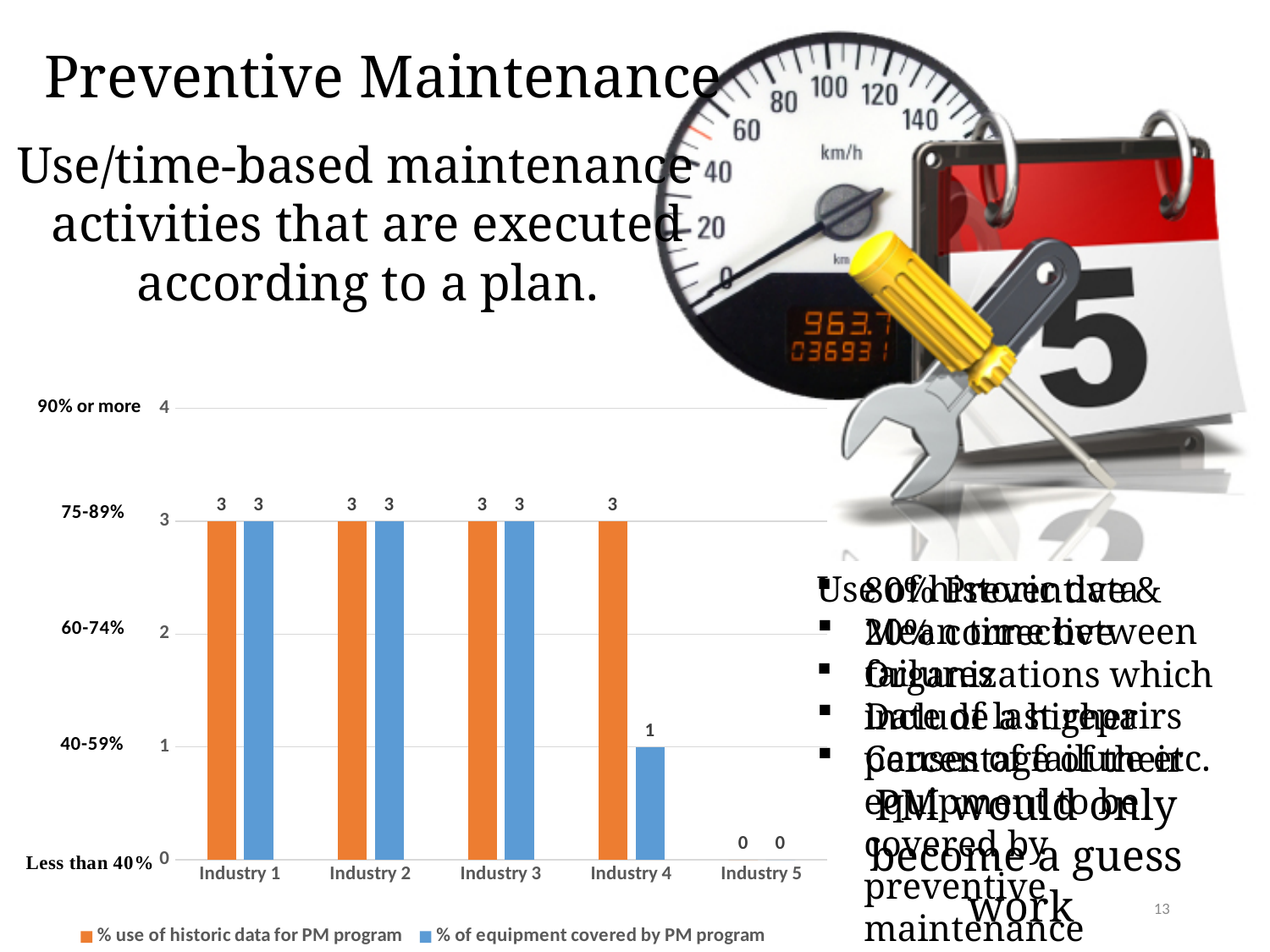
How many series does the chart legend list? 2 What is the value for Industry 5 in the '% use of historic data for PM program' series? 0 What is the value for Industry 2 in the '% of equipment covered by PM program' series? 3 What is the y-axis label shown next to the value 4 on the chart? 90% or more Which colour represents the '% of equipment covered by PM program' series? blue Which industry has the lowest value for '% of equipment covered by PM program'? Industry 5 For Industry 4, which series has the larger value: '% use of historic data for PM program' or '% of equipment covered by PM program'? % use of historic data for PM program How many industries are shown on the x axis of the chart? 5 What is the value for Industry 4 in the '% of equipment covered by PM program' series? 1 What is the value for Industry 4 in the '% use of historic data for PM program' series? 3 What kind of chart is shown on the slide? bar chart What is the difference between the '% use of historic data for PM program' value and the '% of equipment covered by PM program' value for Industry 4? 2